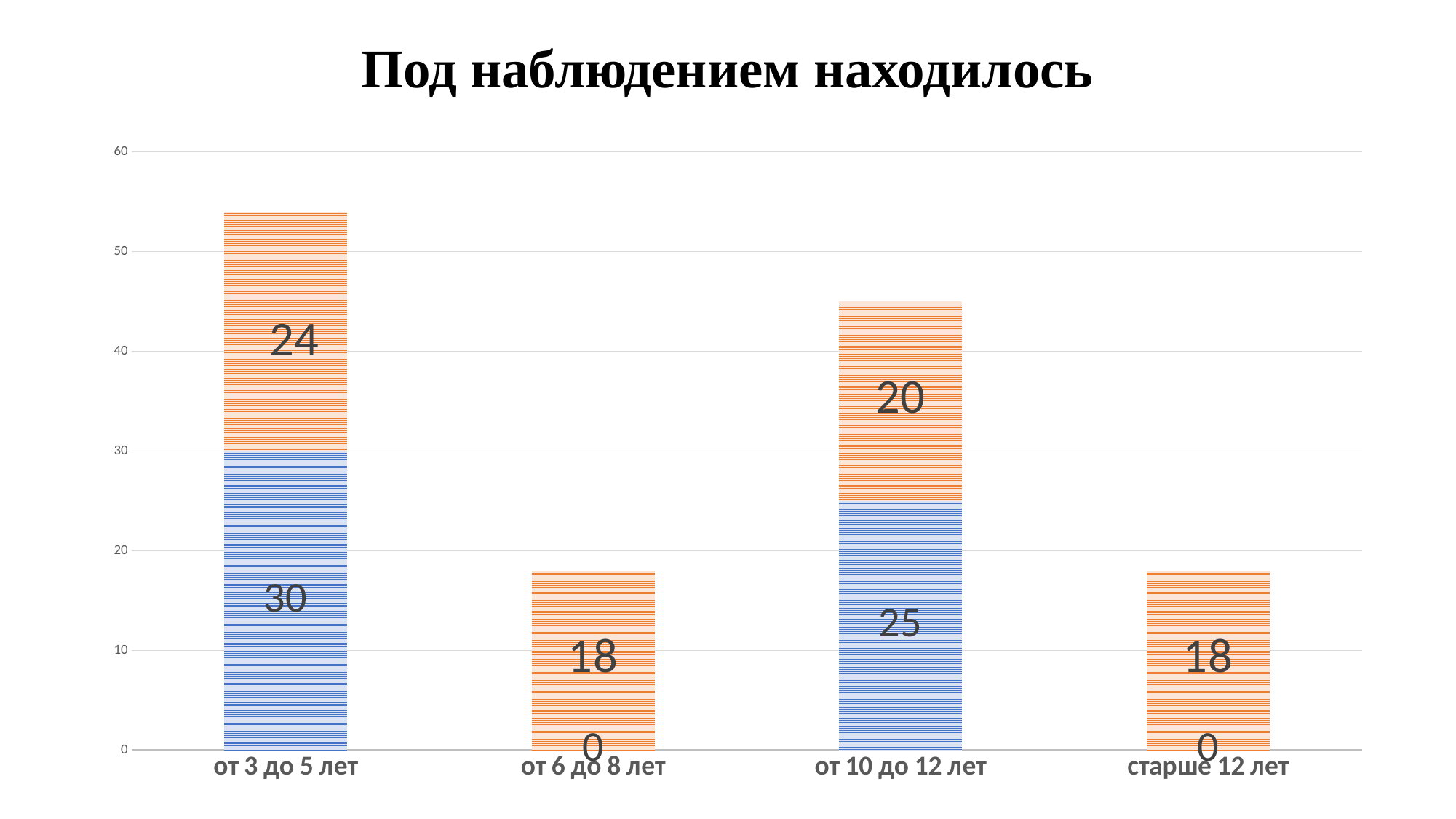
Which category has the tallest stacked bar overall? от 3 до 5 лет How many categories are shown on the x axis? 4 What type of chart is shown on the slide? Stacked bar chart What is the total of the stacked bar for "от 3 до 5 лет"? 54 What is the value of the orange segment for "от 6 до 8 лет"? 18 Which category has the highest orange segment value? от 3 до 5 лет What is the value of the blue segment for "старше 12 лет"? 0 Which is larger: the orange segment for "от 3 до 5 лет" or the orange segment for "от 10 до 12 лет"? от 3 до 5 лет What is the difference between the blue segment values for "от 3 до 5 лет" and "от 10 до 12 лет"? 5 What is the value of the blue segment for "от 3 до 5 лет"? 30 What is the total of the stacked bar for "от 10 до 12 лет"? 45 What is the value of the orange segment for "от 10 до 12 лет"? 20